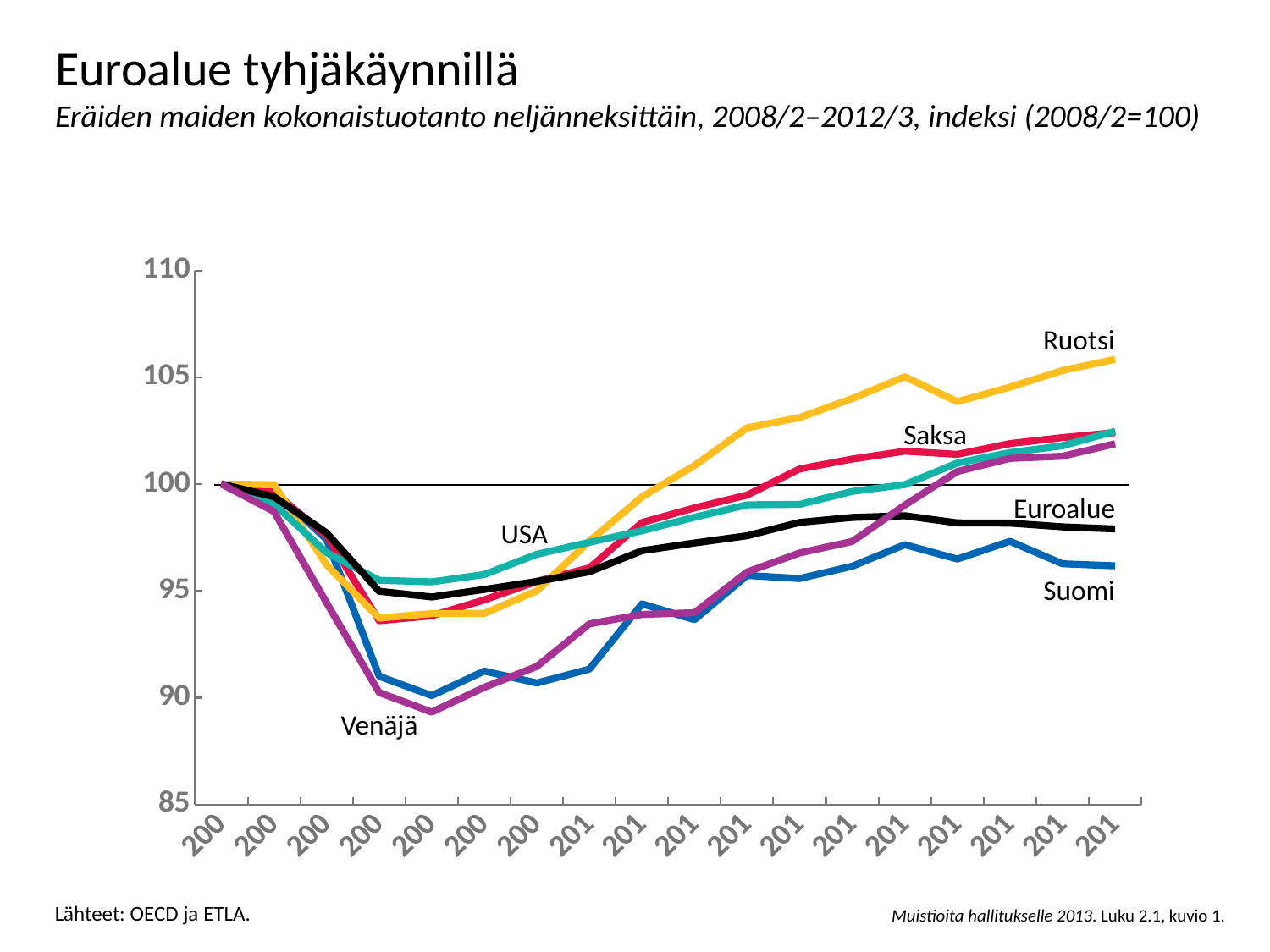
Is the lowest value for Venäjä greater or less than 90? less Is the value for Suomi at the end of the period greater or less than 100? less What index value do all the lines start from at 2008/2? 100 Which line is highest at the right-hand end of the chart? Ruotsi At the end of the period, which is larger, the value for Ruotsi or the value for Suomi? Ruotsi How many countries or regions are plotted as labelled lines on the chart? 6 Is the value for Euroalue at the end of the period greater or less than 100? less Which line reaches the lowest point anywhere on the chart? Venäjä What kind of chart is shown on the slide? line chart Which line is lowest at the right-hand end of the chart? Suomi What is the title of the slide? Euroalue tyhjäkäynnillä